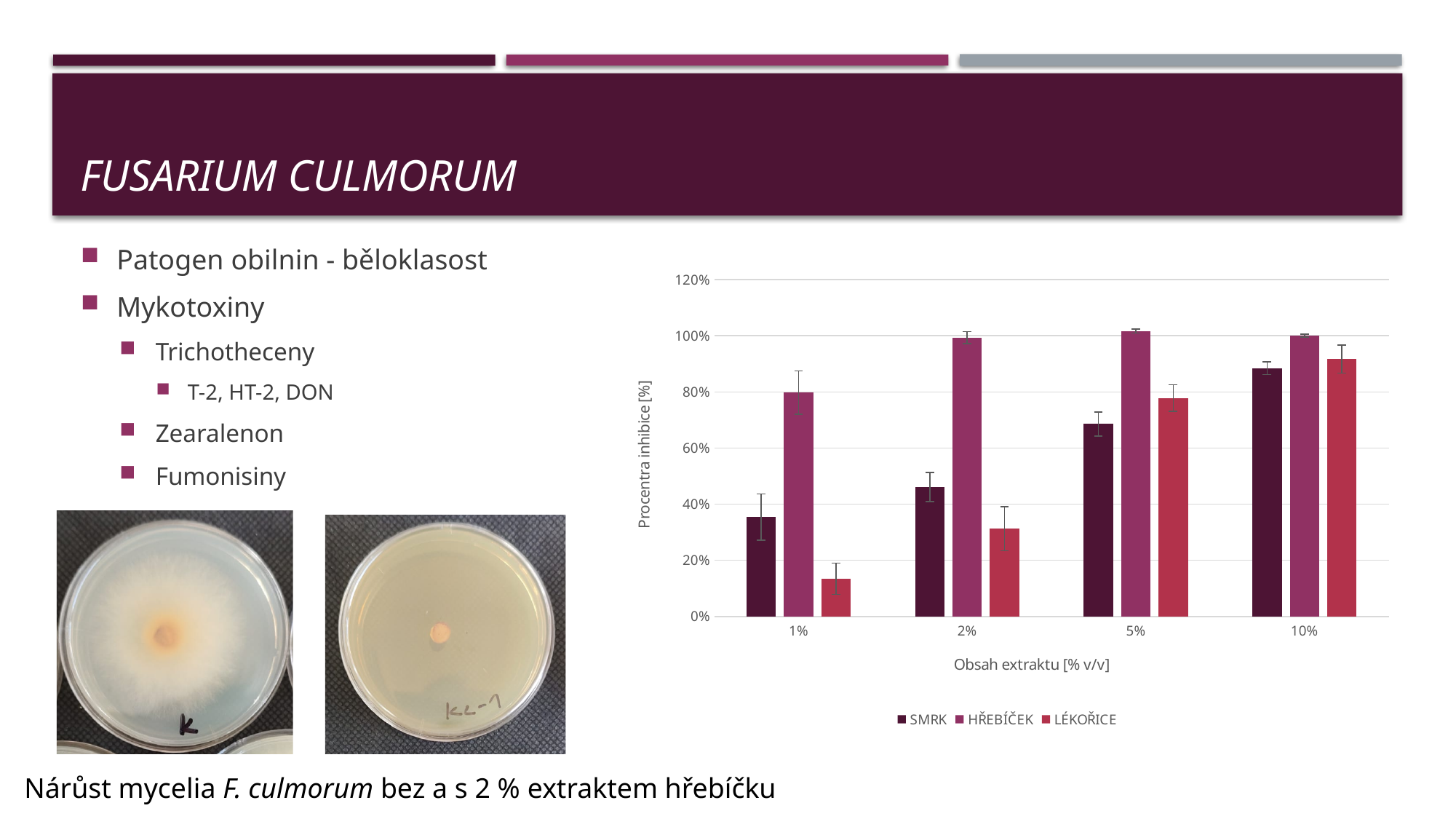
Is the value for HŘEBÍČEK at 2% greater or less than 80%? greater Is the value for SMRK at 1% greater or less than 40%? less Which series has the highest bar at the 1% extract concentration? HŘEBÍČEK What kind of chart is shown on the slide? bar chart Is the value for LÉKOŘICE at 1% greater or less than 20%? less How many extract concentration categories are shown on the x axis? 4 At the 5% extract concentration, which is larger: the SMRK bar or the LÉKOŘICE bar? LÉKOŘICE Do the SMRK values rise or fall as the extract concentration increases from 1% to 10%? rise How many series does the chart legend list? 3 What is the title of the x axis of the chart? Obsah extraktu [% v/v] Which series has the lowest bar at the 1% extract concentration? LÉKOŘICE